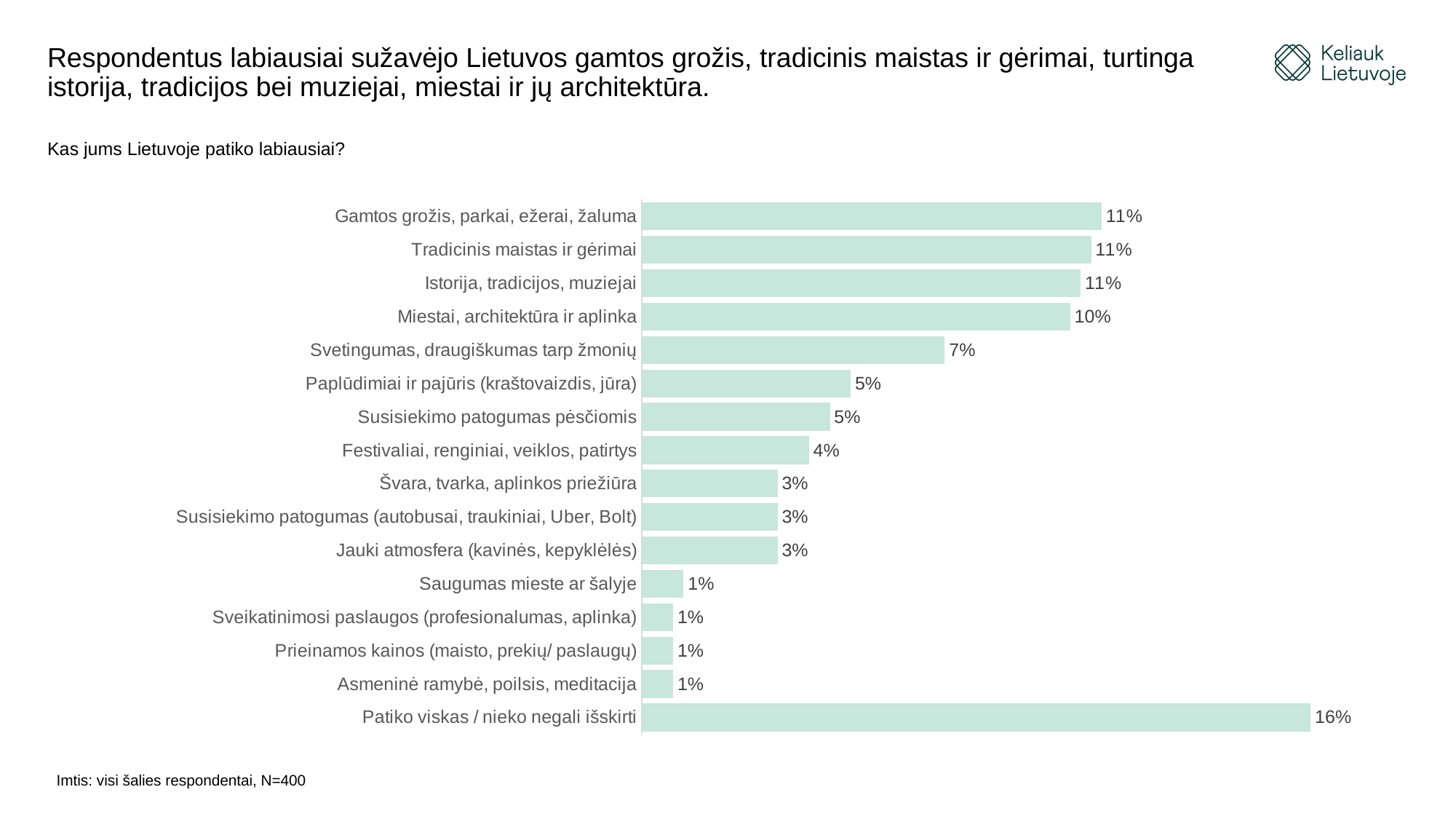
Which is larger: the value for "Svetingumas, draugiškumas tarp žmonių" or for "Paplūdimiai ir pajūris (kraštovaizdis, jūra)"? Svetingumas, draugiškumas tarp žmonių What is the difference between the value for "Gamtos grožis, parkai, ežerai, žaluma" and the value for "Švara, tvarka, aplinkos priežiūra"? 8 percentage points What is the value for "Saugumas mieste ar šalyje"? 1% What question is the chart based on, as shown above the chart? Kas jums Lietuvoje patiko labiausiai? What is the value for "Miestai, architektūra ir aplinka"? 10% How many categories are plotted in the chart? 16 What kind of chart is shown on the slide? bar chart What is the value for "Patiko viskas / nieko negali išskirti"? 16% What is the value for "Svetingumas, draugiškumas tarp žmonių"? 7% Which category has the highest value in the chart? Patiko viskas / nieko negali išskirti What is the value for "Festivaliai, renginiai, veiklos, patirtys"? 4% What is the difference between the value for "Patiko viskas / nieko negali išskirti" and the value for "Miestai, architektūra ir aplinka"? 6 percentage points